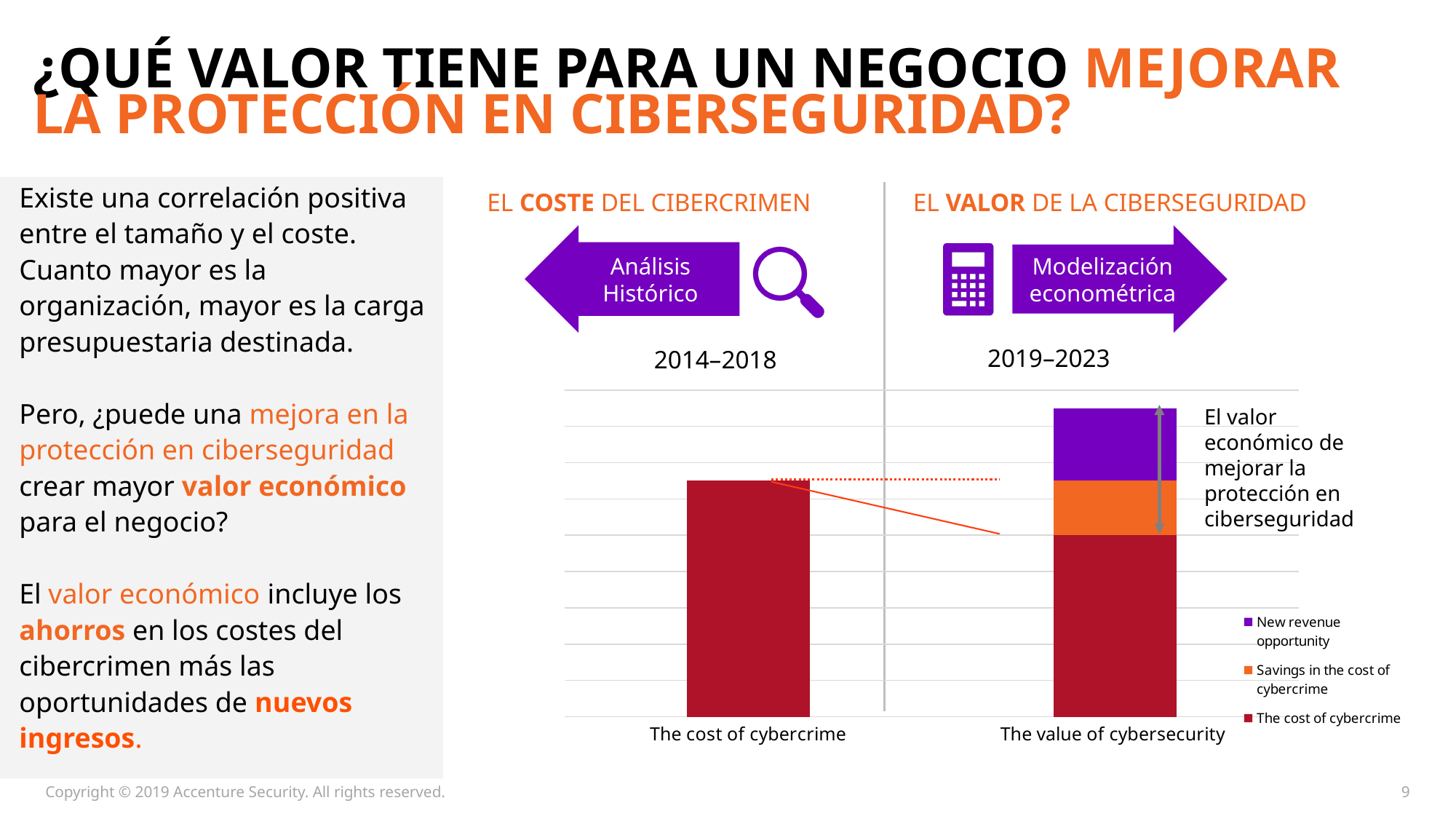
Within the 'The value of cybersecurity' bar, which series occupies the largest segment? The cost of cybercrime Is the red 'The cost of cybercrime' segment in the 'The value of cybersecurity' bar taller or shorter than the 'The cost of cybercrime' bar? Shorter Which bar is taller overall, 'The cost of cybercrime' or 'The value of cybersecurity'? The value of cybersecurity How many bars (categories) does the chart show? 2 Which series is shown in orange in the legend? Savings in the cost of cybercrime Which category has the highest total bar height? The value of cybersecurity What kind of chart is shown on the slide? Stacked bar chart How many series does the chart legend list? 3 Which series is shown in purple in the legend? New revenue opportunity Which category has the lowest total bar height? The cost of cybercrime